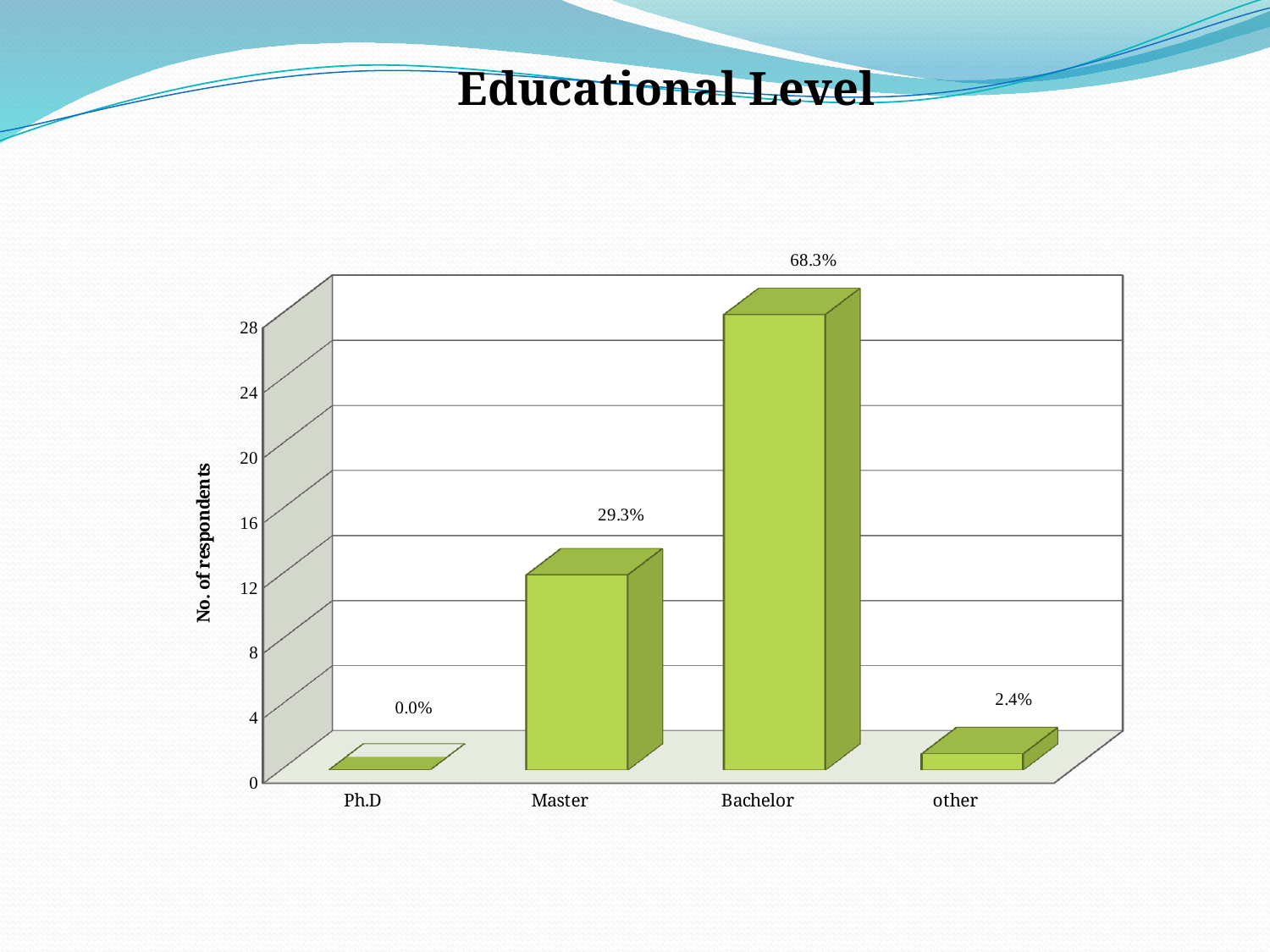
Which educational level has the lowest number of respondents? Ph.D Is the number of respondents for Bachelor greater or less than 24? greater Which has more respondents, Master or other? Master Is the number of respondents for Master greater or less than 16? less What kind of chart is shown on the slide? Bar chart What is the data label shown for Master? 29.3% What is the data label shown for Ph.D? 0.0% How many educational level categories are shown on the x axis? 4 What is the difference between the percentage labels for Bachelor and Master? 39.0% Which educational level has the highest number of respondents? Bachelor What is the data label shown for the 'other' category? 2.4% What is the data label shown for Bachelor? 68.3%